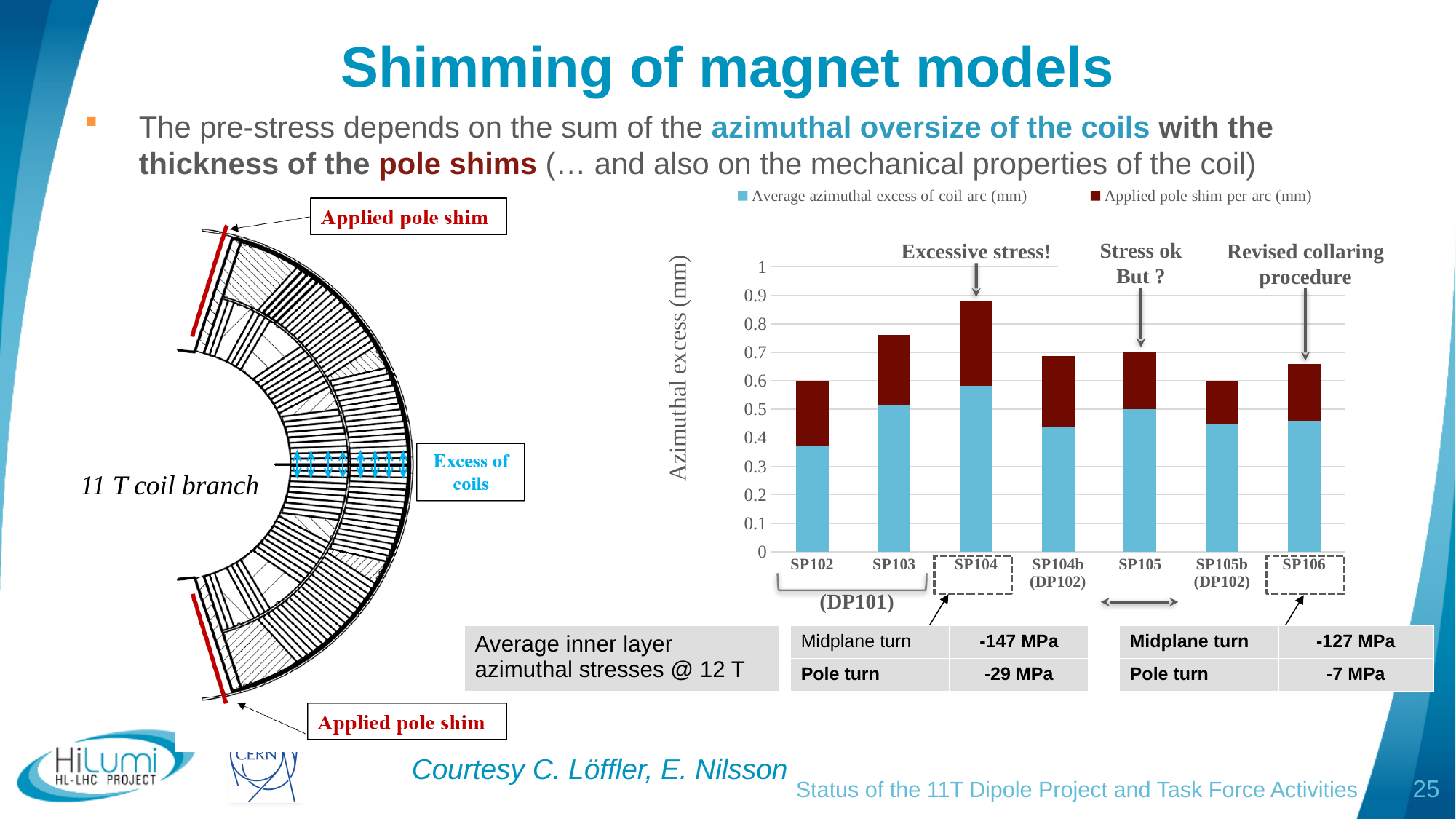
What kind of chart is shown on the slide? Stacked bar chart Which magnet model has the highest value for the 'Average azimuthal excess of coil arc (mm)' series? SP104 How many magnet models (categories) are plotted on the x axis of the chart? 7 Which series is shown in dark red in the chart? Applied pole shim per arc (mm) Which magnet model has the highest total bar in the chart? SP104 Is the 'Average azimuthal excess of coil arc (mm)' value for SP102 greater or less than 0.4? less Which magnet model has the lowest value for the 'Average azimuthal excess of coil arc (mm)' series? SP102 How many series does the chart legend list? 2 Is the total bar height for SP104 greater or less than 0.8? greater Is the total bar height for SP102 greater or less than 0.7? less What is the title of the chart's vertical axis? Azimuthal excess (mm) Which has the larger total bar, SP103 or SP104b (DP102)? SP103